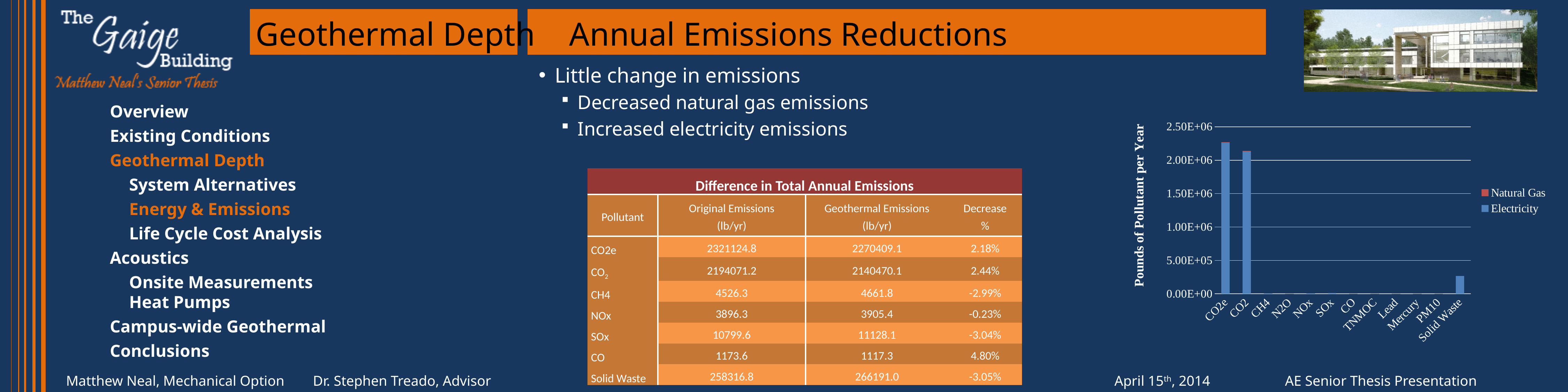
Which series in the chart's legend is shown in blue? Electricity Is the value for Solid Waste in the chart greater or less than 5.00E+05? less How many pollutant categories are shown on the x axis of the chart? 12 What is the highest tick value shown on the chart's y axis? 2.50E+06 Which has a larger bar in the chart, CO2 or CH4? CO2 What kind of chart is shown on the slide? bar chart Which pollutant has the tallest bar in the chart? CO2e Is the value for CO2 in the chart greater or less than 1.50E+06? greater What is the title of the chart's y axis? Pounds of Pollutant per Year Which has a larger bar in the chart, CO2e or Solid Waste? CO2e Is the value for CO2e in the chart greater or less than 2.00E+06? greater How many series does the chart's legend list? 2